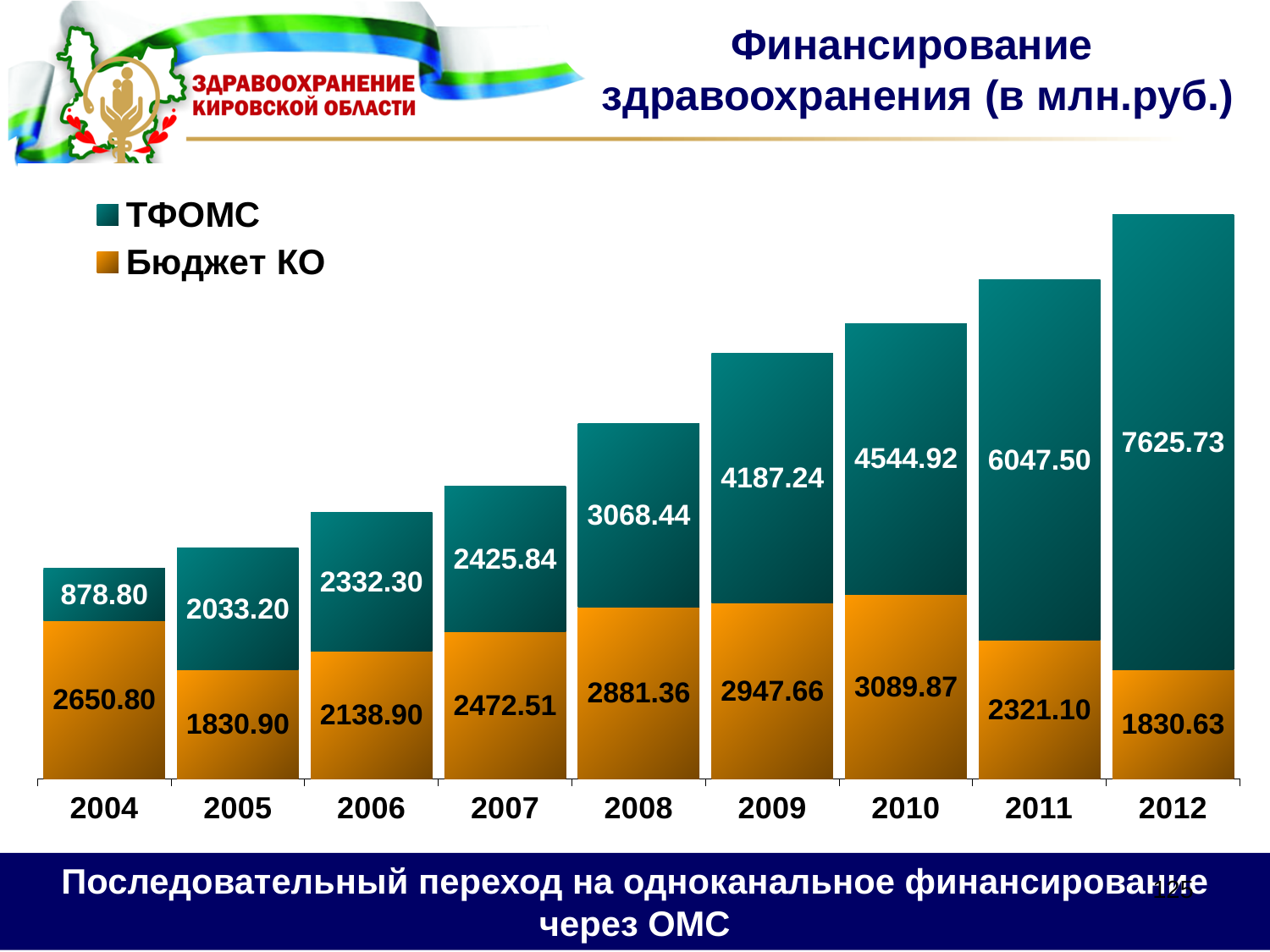
What is the Бюджет КО value for 2004? 2650.80 How many years are shown on the x axis? 9 Which year has the highest Бюджет КО value? 2010 What is the total of the stacked bar for 2004? 3529.60 What kind of chart is shown on the slide? stacked bar chart What is the difference between the ТФОМС values for 2012 and 2011? 1578.23 Which is larger in 2005: the ТФОМС value or the Бюджет КО value? ТФОМС What is the ТФОМС value for 2008? 3068.44 How many series does the legend list? 2 Do the ТФОМС values rise or fall from 2004 to 2012? rise Which year has the lowest ТФОМС value? 2004 What is the ТФОМС value for 2012? 7625.73